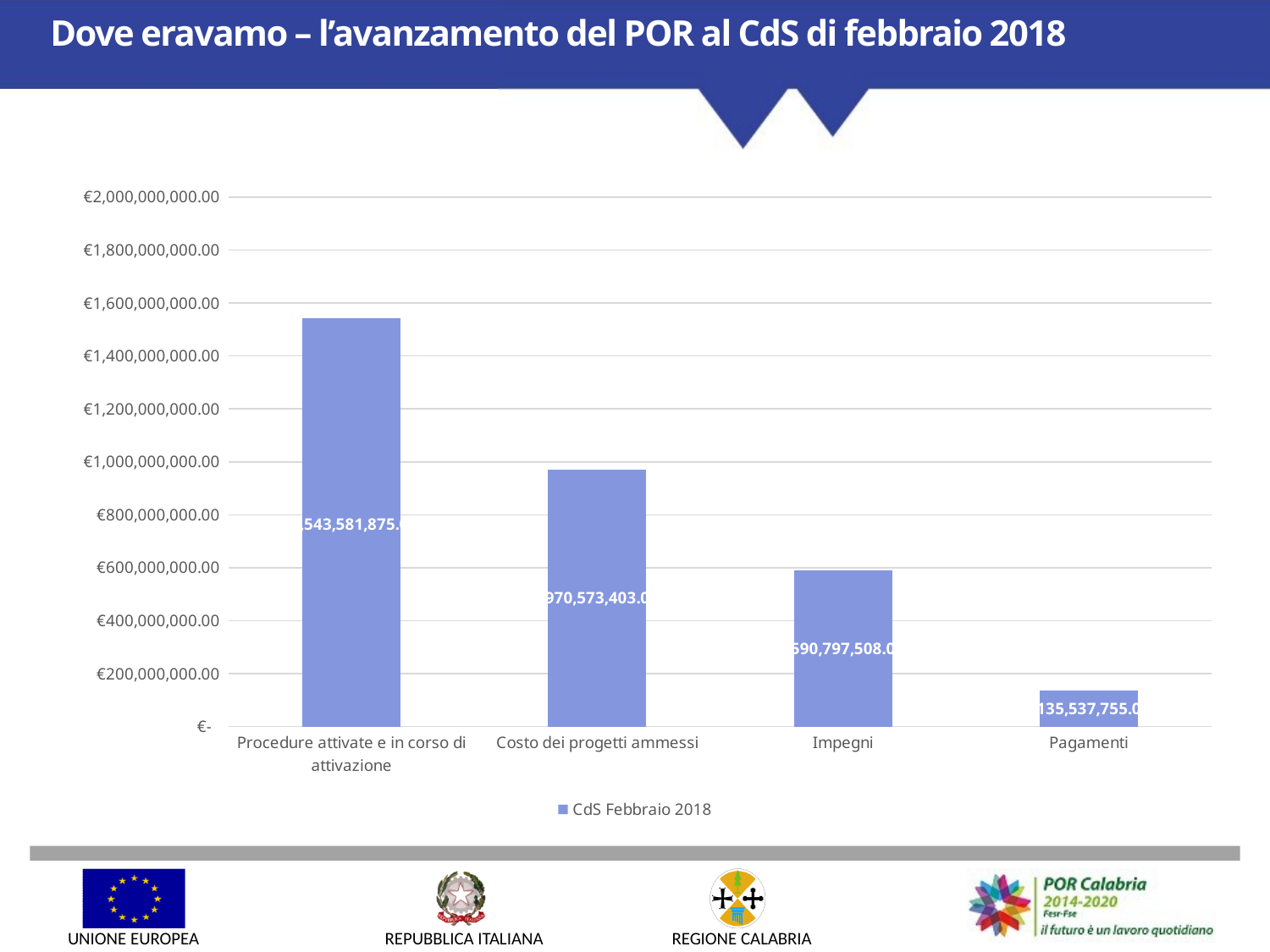
What kind of chart is shown on the slide? bar chart Which category has the lowest value in the chart? Pagamenti Which category has the highest value in the chart? Procedure attivate e in corso di attivazione Do the values rise or fall moving from left to right along the x axis? fall Is the value for Pagamenti greater or less than €200,000,000.00? less What is the name of the series shown in the chart legend? CdS Febbraio 2018 Is the value for Impegni greater or less than €800,000,000.00? less How many series does the chart legend list? 1 Which is larger, the value for Costo dei progetti ammessi or the value for Impegni? Costo dei progetti ammessi How many categories are shown on the x axis of the chart? 4 Is the value for Costo dei progetti ammessi greater or less than €800,000,000.00? greater